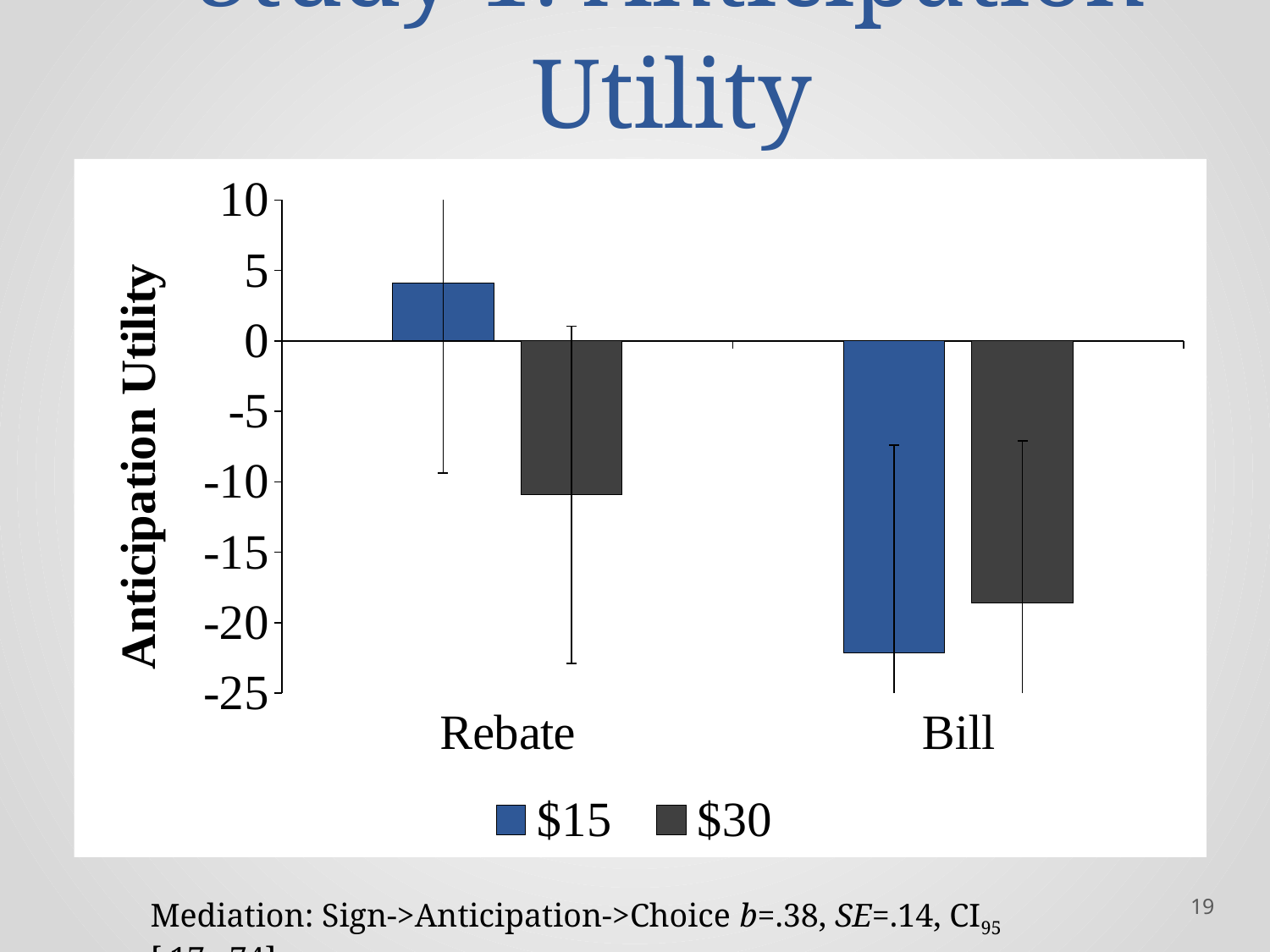
What are the two series named in the legend? $15 and $30 Is the value for $15 in the Rebate condition greater or less than 0? greater What is the label of the vertical axis? Anticipation Utility Which category and series combination has the lowest anticipation utility? Bill, $15 How many series does the chart's legend list? 2 Which category and series combination has the highest anticipation utility? Rebate, $15 How many categories are shown on the x axis of the chart? 2 Is the value for $30 in the Bill condition greater or less than -15? less Is the value for $15 in the Bill condition greater or less than -20? less What kind of chart is shown on the slide? bar chart In the Bill condition, which series has the larger anticipation utility, $15 or $30? $30